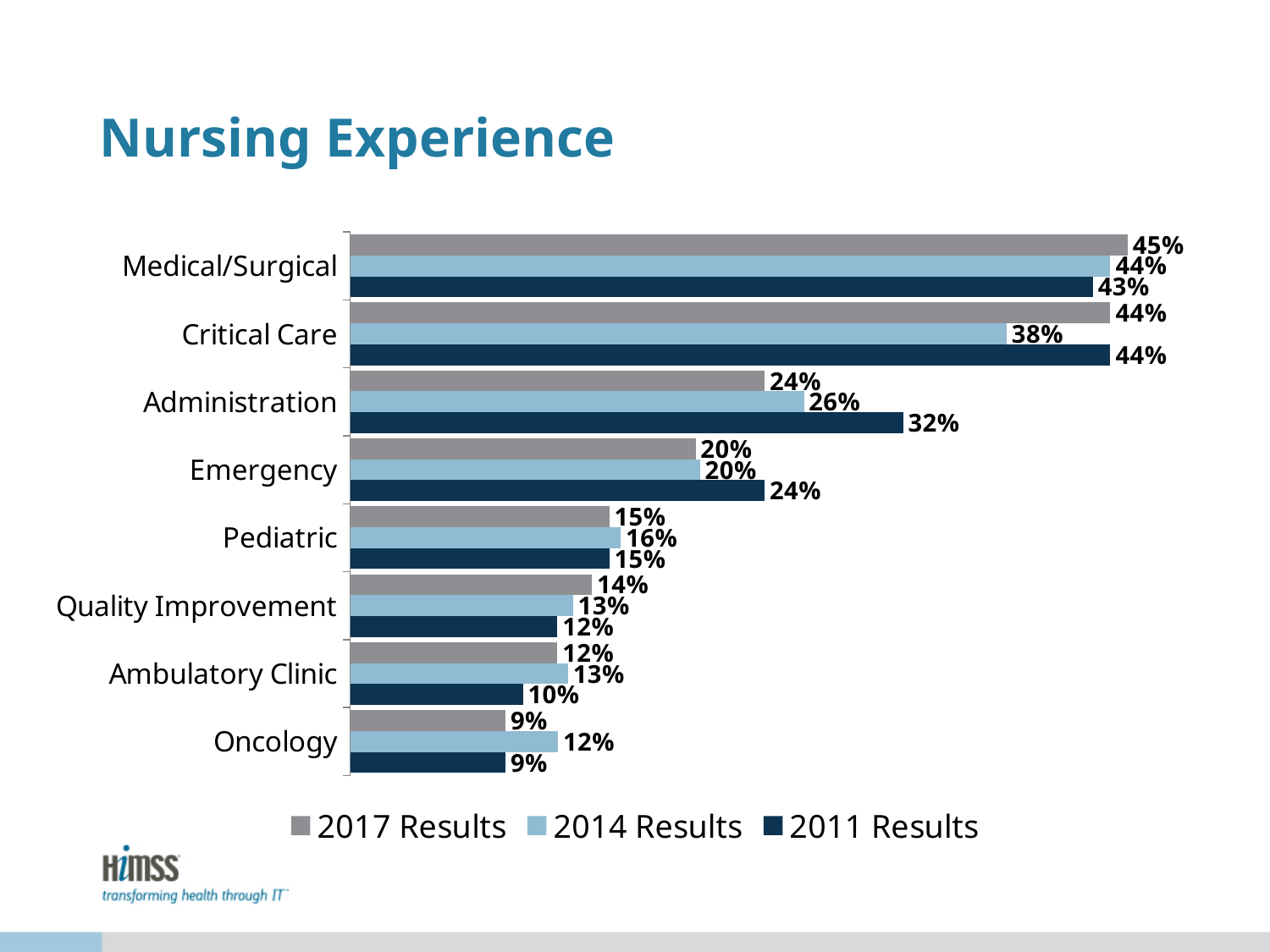
What is the 2014 Results value for Oncology? 12% What is the 2014 Results value for Critical Care? 38% What is the title of the slide? Nursing Experience Which category has the lowest 2011 Results value? Oncology What kind of chart is shown on the slide? Bar chart Which category has the highest 2017 Results value? Medical/Surgical How many series does the legend list? 3 What is the 2011 Results value for Administration? 32% How many categories are shown on the chart? 8 What is the 2017 Results value for Medical/Surgical? 45% What is the difference between the 2011 Results and 2017 Results values for Administration? 8% Which is larger for Emergency: the 2011 Results value or the 2017 Results value? 2011 Results